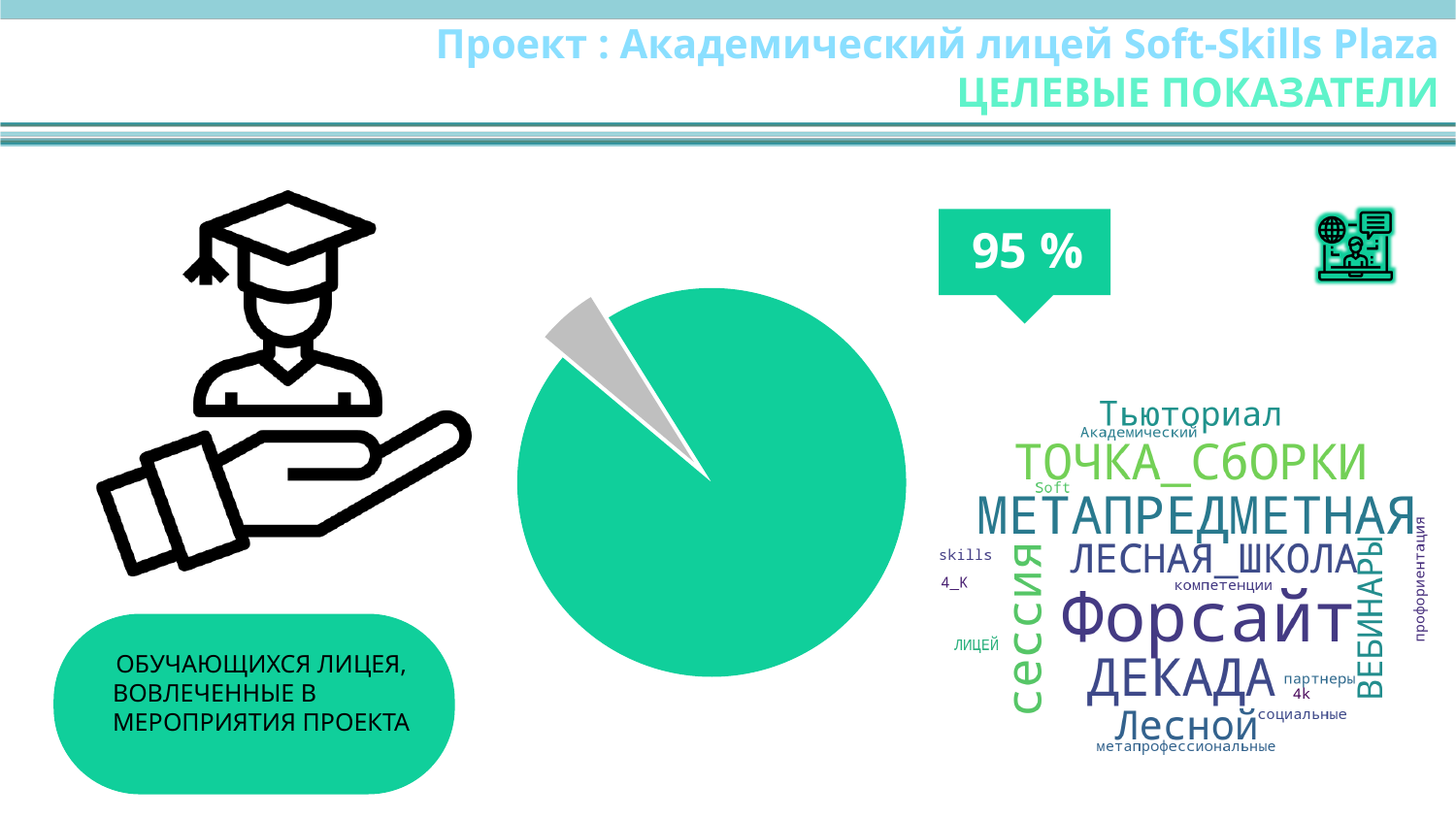
Which slice of the pie chart is larger, the green one or the grey one? the green one How many slices does the pie chart have? 2 What colour is the small exploded slice of the pie chart? grey What kind of chart is shown on the slide? pie chart What share of the pie does the large green slice represent, according to the label on the slide? 95 % Does the pie chart display a legend? No What colour is the largest slice of the pie chart? green